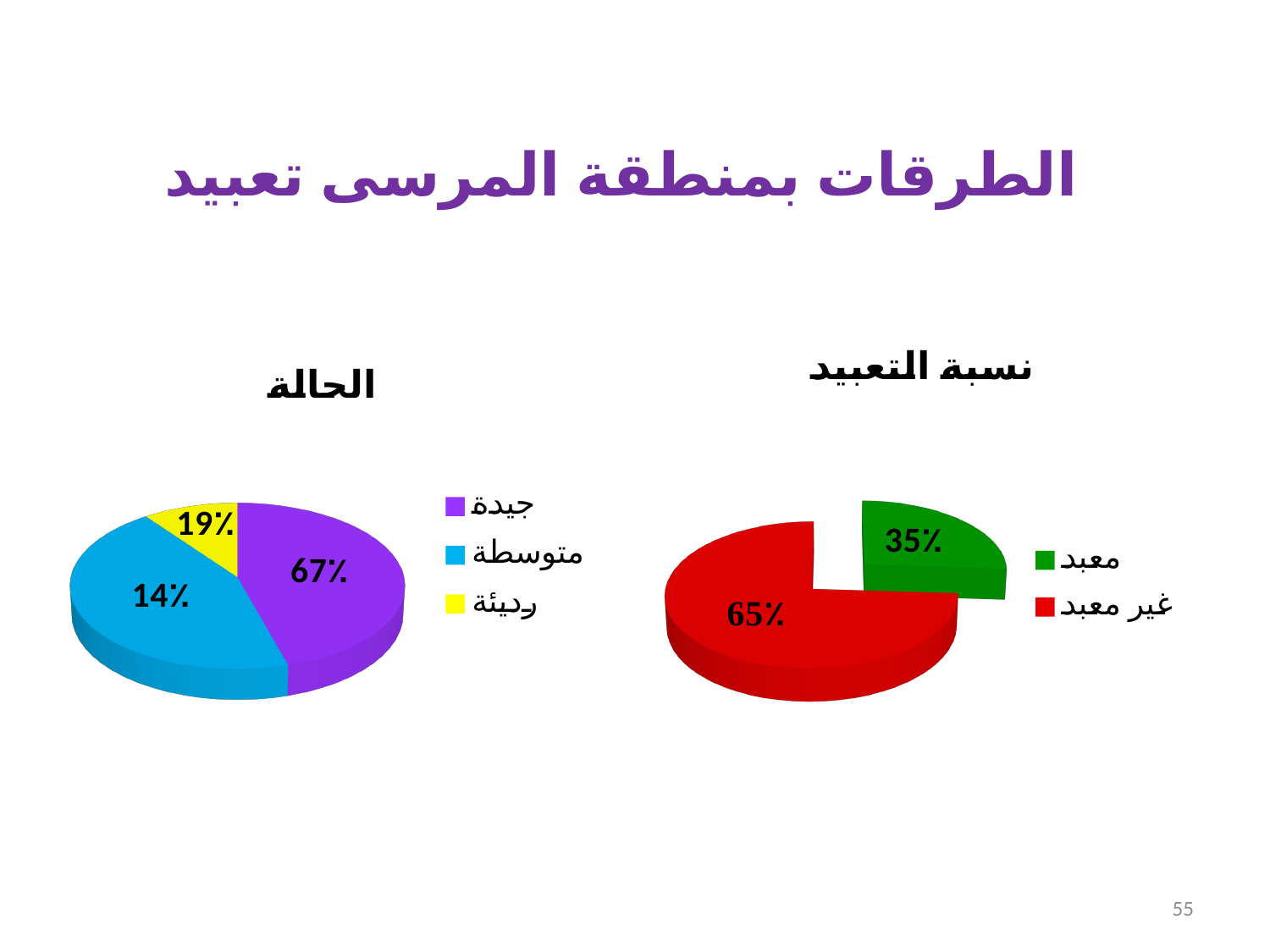
On the chart titled "الحالة", which category has the largest share? جيدة On the chart titled "نسبة التعبيد", what percentage is shown for "غير معبد"? 65% On the chart titled "نسبة التعبيد", how many entries does the legend list? 2 On the chart titled "نسبة التعبيد", what percentage is shown for "معبد"? 35% On the chart titled "الحالة", what percentage label is shown on the "رديئة" slice? 19% On the chart titled "نسبة التعبيد", what is the difference in percentage points between "غير معبد" and "معبد"? 30 On the chart titled "الحالة", how many slices does the pie have? 3 What type of chart is the one titled "نسبة التعبيد"? Pie chart On the chart titled "الحالة", what percentage is shown for "جيدة"? 67% On the chart titled "الحالة", what percentage label is shown on the "متوسطة" slice? 14% On the chart titled "الحالة", what colour is the "جيدة" slice? Purple On the chart titled "نسبة التعبيد", which category has the larger share? غير معبد